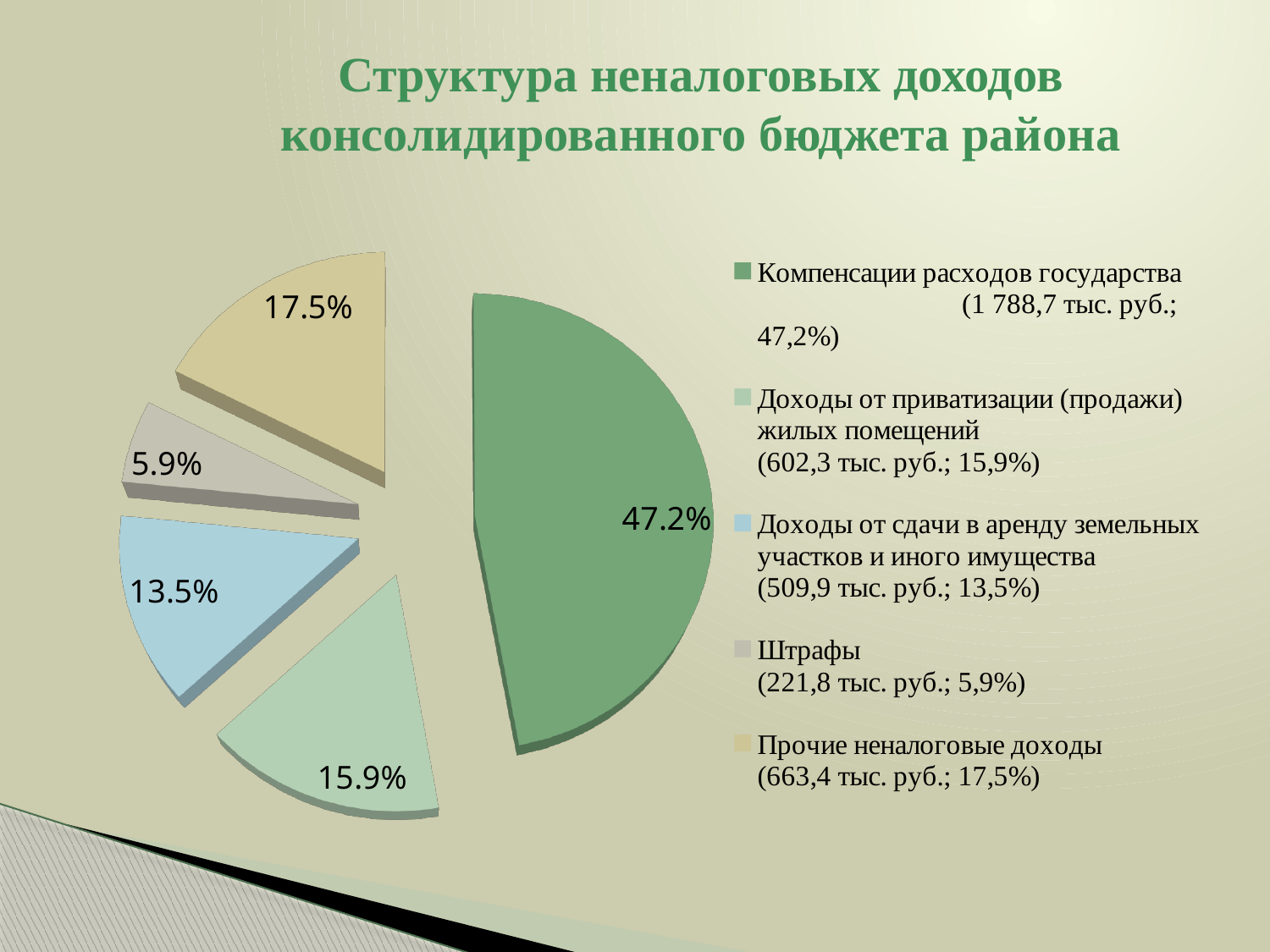
By how many percentage points does the share of «Компенсации расходов государства» exceed that of «Доходы от сдачи в аренду земельных участков и иного имущества»? 33.7 percentage points What type of chart is shown on the slide? Pie chart By how many percentage points does the share of «Прочие неналоговые доходы» exceed that of «Доходы от приватизации (продажи) жилых помещений»? 1.6 percentage points What percentage share is shown for «Штрафы»? 5.9% What percentage of non-tax revenue does the slice for «Компенсации расходов государства» represent? 47.2% According to the legend, what amount in thousand rubles corresponds to «Штрафы»? 221,8 тыс. руб. Which category has the smallest slice of the pie? Штрафы What is the title of the chart on the slide? Структура неналоговых доходов консолидированного бюджета района How many slices does the pie chart have? 5 Which category has the largest slice of the pie? Компенсации расходов государства Which is larger: the share for «Доходы от приватизации (продажи) жилых помещений» or for «Доходы от сдачи в аренду земельных участков и иного имущества»? Доходы от приватизации (продажи) жилых помещений What percentage share is shown for «Прочие неналоговые доходы»? 17.5%